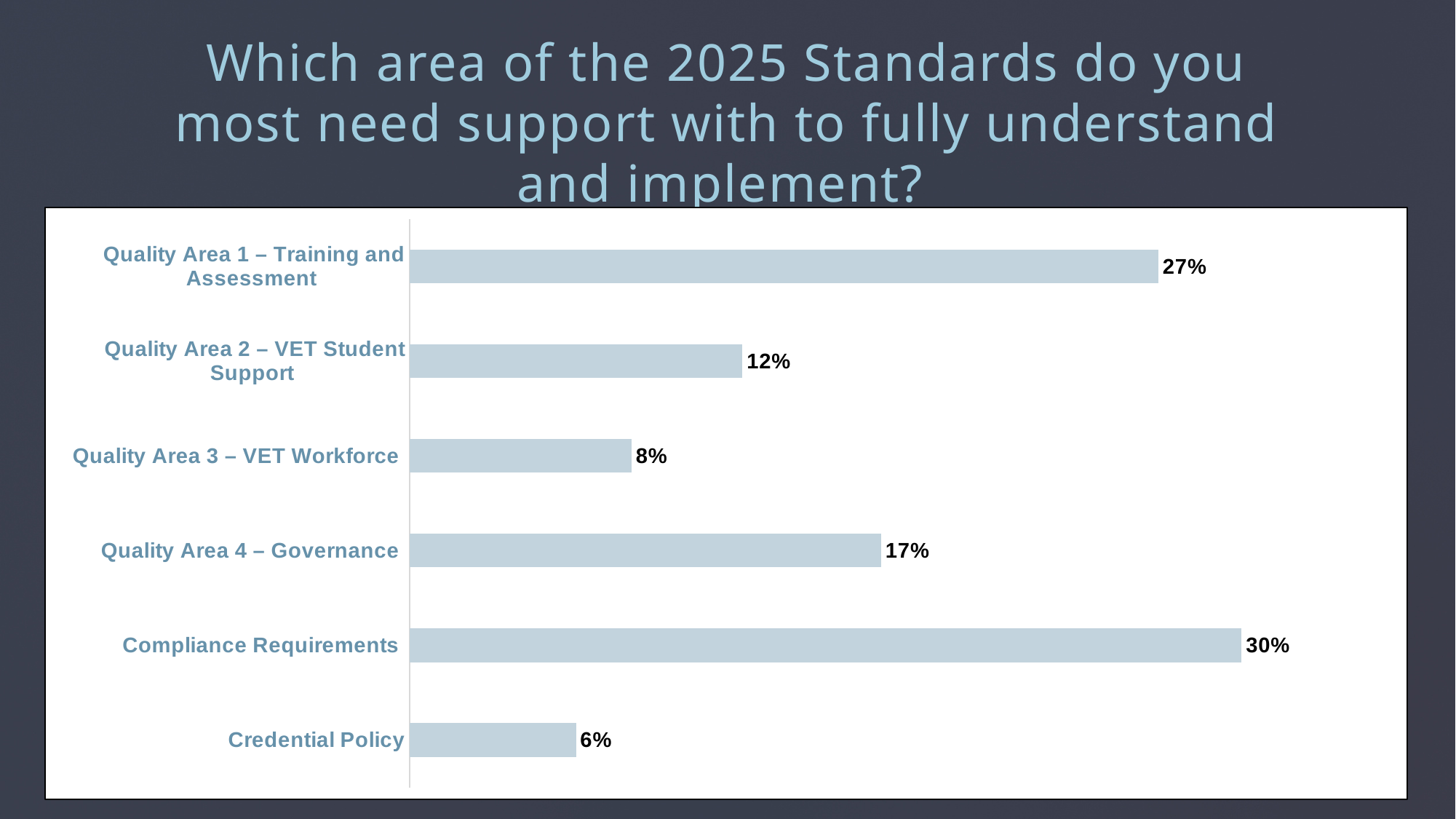
What is the value for Compliance Requirements? 30% What is the difference between the values for Compliance Requirements and Quality Area 4 – Governance? 13% What kind of chart is shown on the slide? Bar chart What is the title of the slide? Which area of the 2025 Standards do you most need support with to fully understand and implement? Which category has the lowest value? Credential Policy What is the difference between the values for Quality Area 1 – Training and Assessment and Quality Area 2 – VET Student Support? 15% What is the value for Quality Area 3 – VET Workforce? 8% Which category has the highest value? Compliance Requirements What is the value for Quality Area 4 – Governance? 17% How many categories are shown in the chart? 6 What is the value for Credential Policy? 6% Which is larger, the value for Quality Area 2 – VET Student Support or the value for Quality Area 4 – Governance? Quality Area 4 – Governance